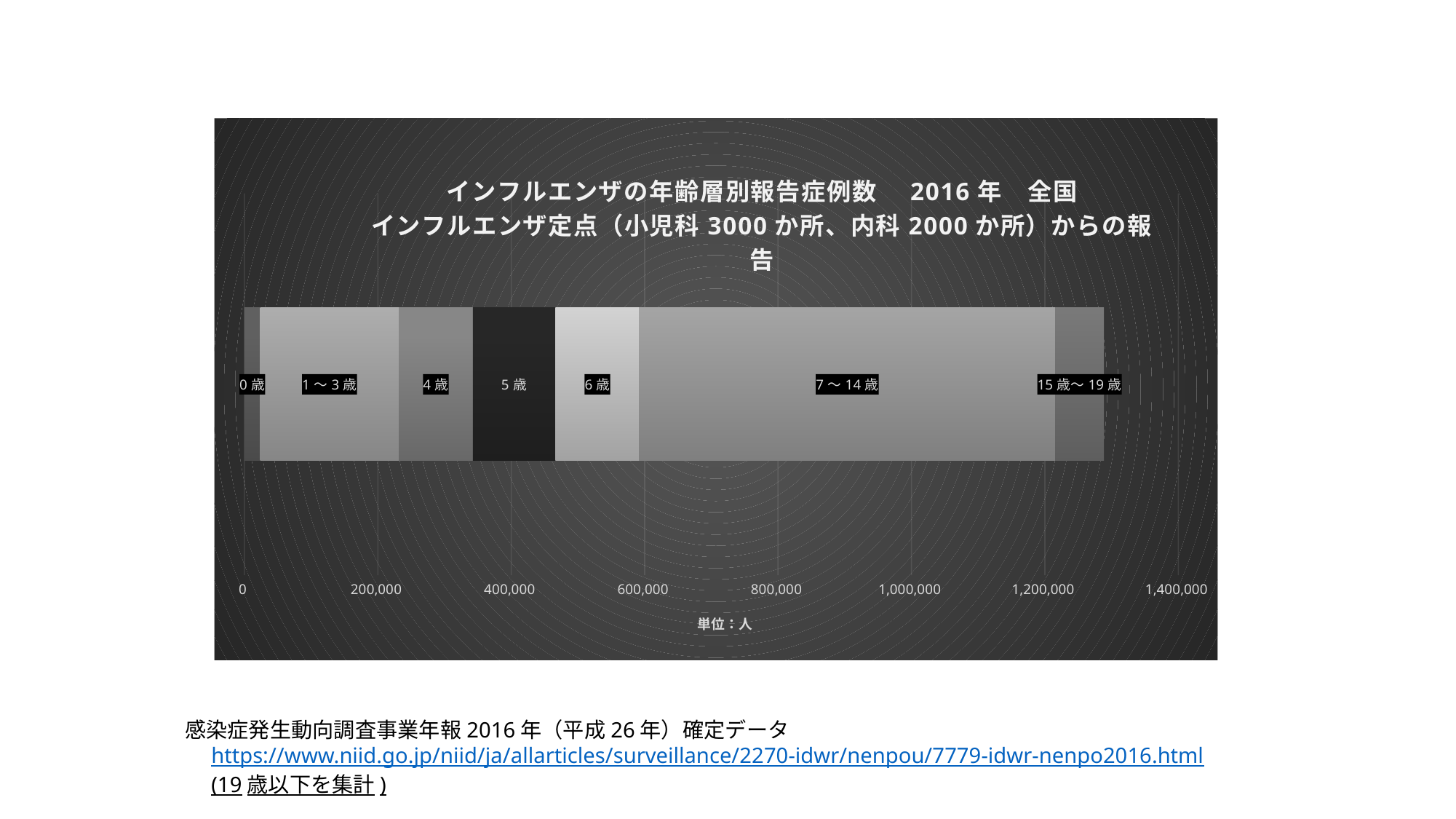
Is the value for the 5歳 segment greater or less than 200,000? less What unit label is shown below the horizontal axis? 単位：人 Which segment is larger, 15歳～19歳 or 0歳? 15歳～19歳 How many age-group segments make up the bar? 7 Which segment is larger, 7～14歳 or 1～3歳? 7～14歳 What kind of chart is shown on the slide? stacked bar chart Is the total length of the stacked bar greater or less than 1,200,000? greater Is the total length of the stacked bar greater or less than 1,400,000? less Which age group has the largest segment in the bar? 7～14歳 Which segment is larger, 1～3歳 or 4歳? 1～3歳 Which age group has the smallest segment in the bar? 0歳